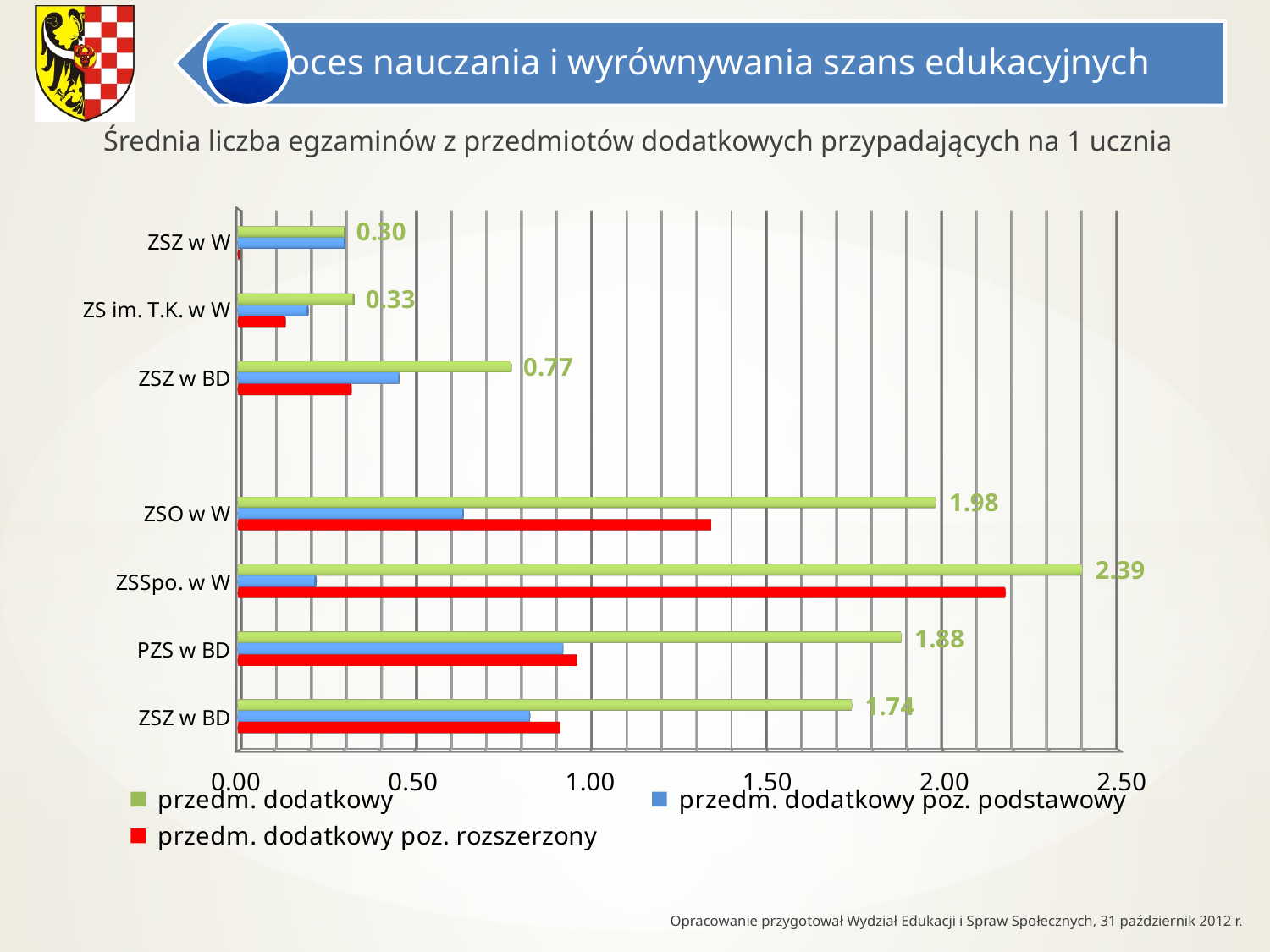
What is the value of przedm. dodatkowy for ZS im. T.K. w W? 0.33 What is the difference between the przedm. dodatkowy values for ZSSpo. w W and ZSO w W? 0.41 Which school has the lowest value for przedm. dodatkowy? ZSZ w W Is the value of przedm. dodatkowy poz. podstawowy for ZSO w W greater or less than 1.00? less What is the value of przedm. dodatkowy for ZSSpo. w W? 2.39 How many series does the legend list? 3 Which school has the highest value for przedm. dodatkowy? ZSSpo. w W Is the value of przedm. dodatkowy poz. rozszerzony for ZSSpo. w W greater or less than 2.00? greater What kind of chart is shown on the slide? bar chart Which has a larger przedm. dodatkowy value, PZS w BD or ZSO w W? ZSO w W What is the value of przedm. dodatkowy for ZSO w W? 1.98 What is the value of przedm. dodatkowy for PZS w BD? 1.88